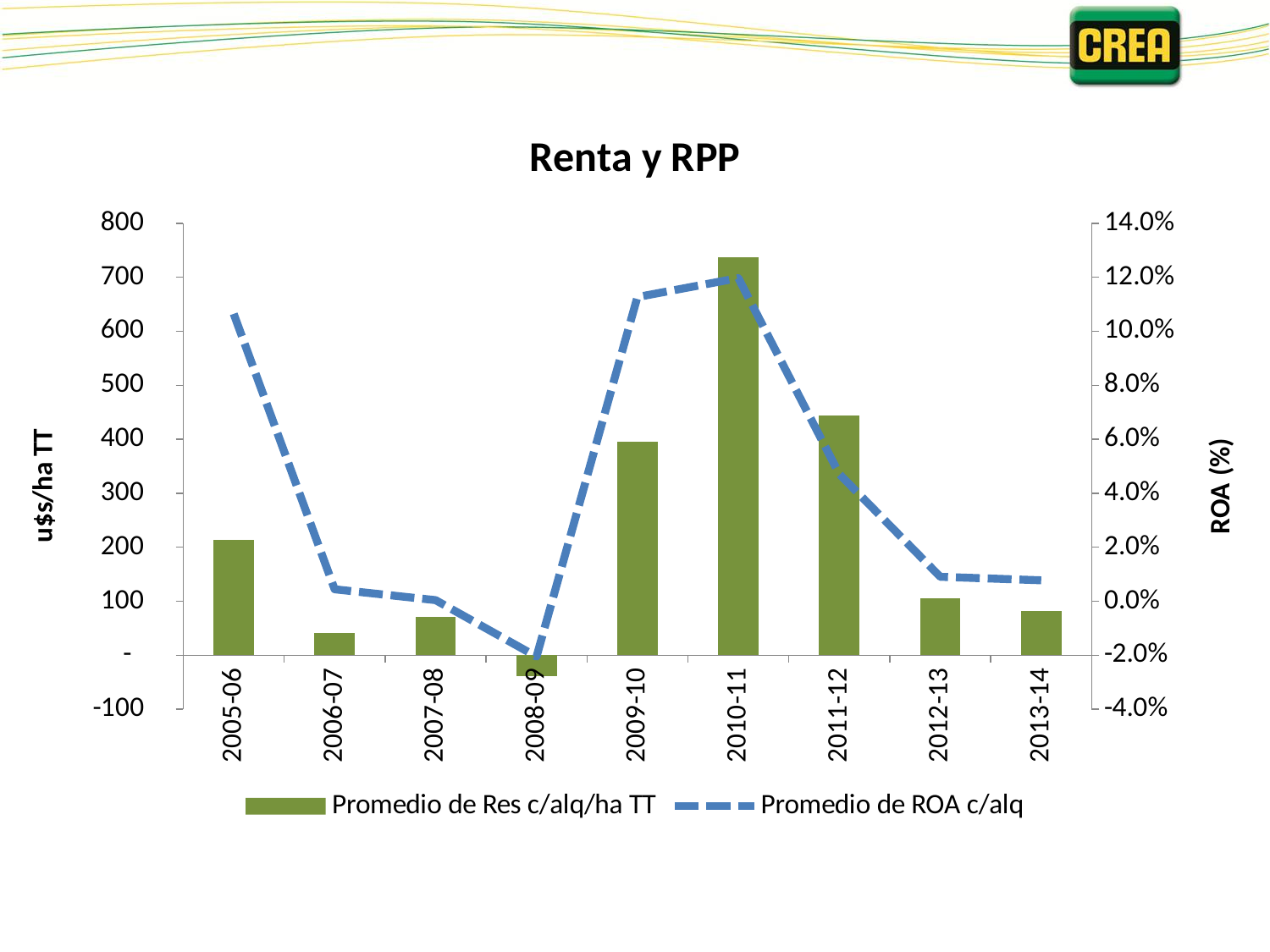
Is the Promedio de ROA c/alq value for 2005-06 greater or less than 8.0%? greater Does the Promedio de ROA c/alq line rise or fall from 2010-11 to 2013-14? fall What is the title of the chart? Renta y RPP What kind of chart is shown on the slide? Combined bar and line chart Which period has the lowest bar for Promedio de Res c/alq/ha TT? 2008-09 Is the Promedio de Res c/alq/ha TT bar for 2009-10 greater or less than 300? greater How many series does the legend list? 2 Is the Promedio de Res c/alq/ha TT bar for 2010-11 greater or less than 700? greater Which period has the highest bar for Promedio de Res c/alq/ha TT? 2010-11 Which period has a larger Promedio de Res c/alq/ha TT bar, 2011-12 or 2012-13? 2011-12 How many periods are shown on the x axis of the chart? 9 What is the label of the right-hand vertical axis? ROA (%)